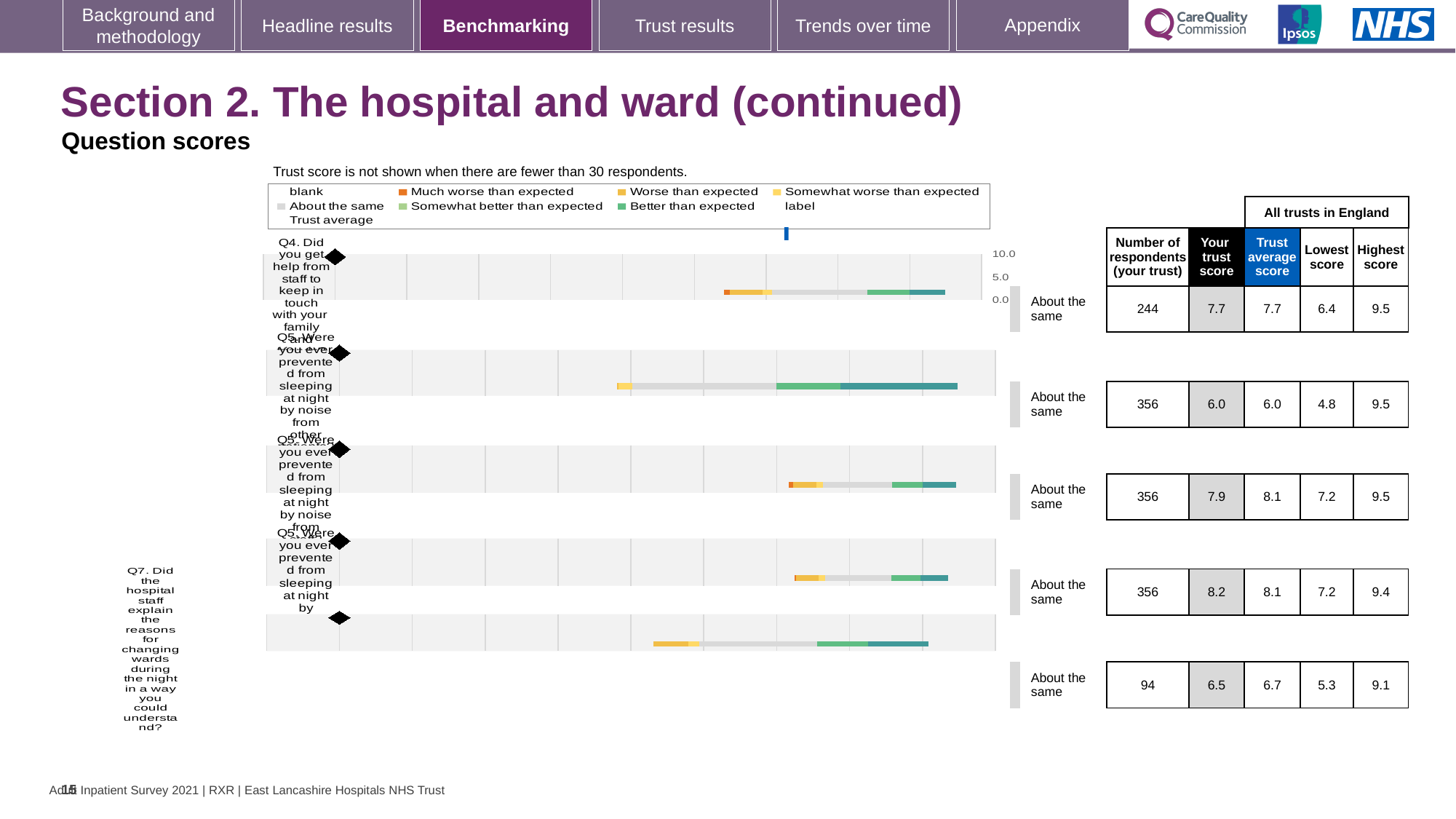
Which has the higher 'Your trust score', Q4 or Q7? Q4 What is the lowest score across all trusts in England for Q7 (explaining reasons for changing wards during the night)? 5.3 How many respondents are shown for Q4 (help from staff to keep in touch with family and friends)? 244 How many respondents are shown for Q7? 94 What is the trust average score for Q4? 7.7 What is the highest score across all trusts in England for Q4? 9.5 What kind of chart is used to show the question scores on this slide? bar chart What is the 'Your trust score' value for Q4? 7.7 How many question rows (bars) are plotted in the chart? 5 What is the difference between the highest score and the lowest score for Q7? 3.8 What benchmark category is shown next to the Q4 bar? About the same Which question has the fewest respondents? Q7